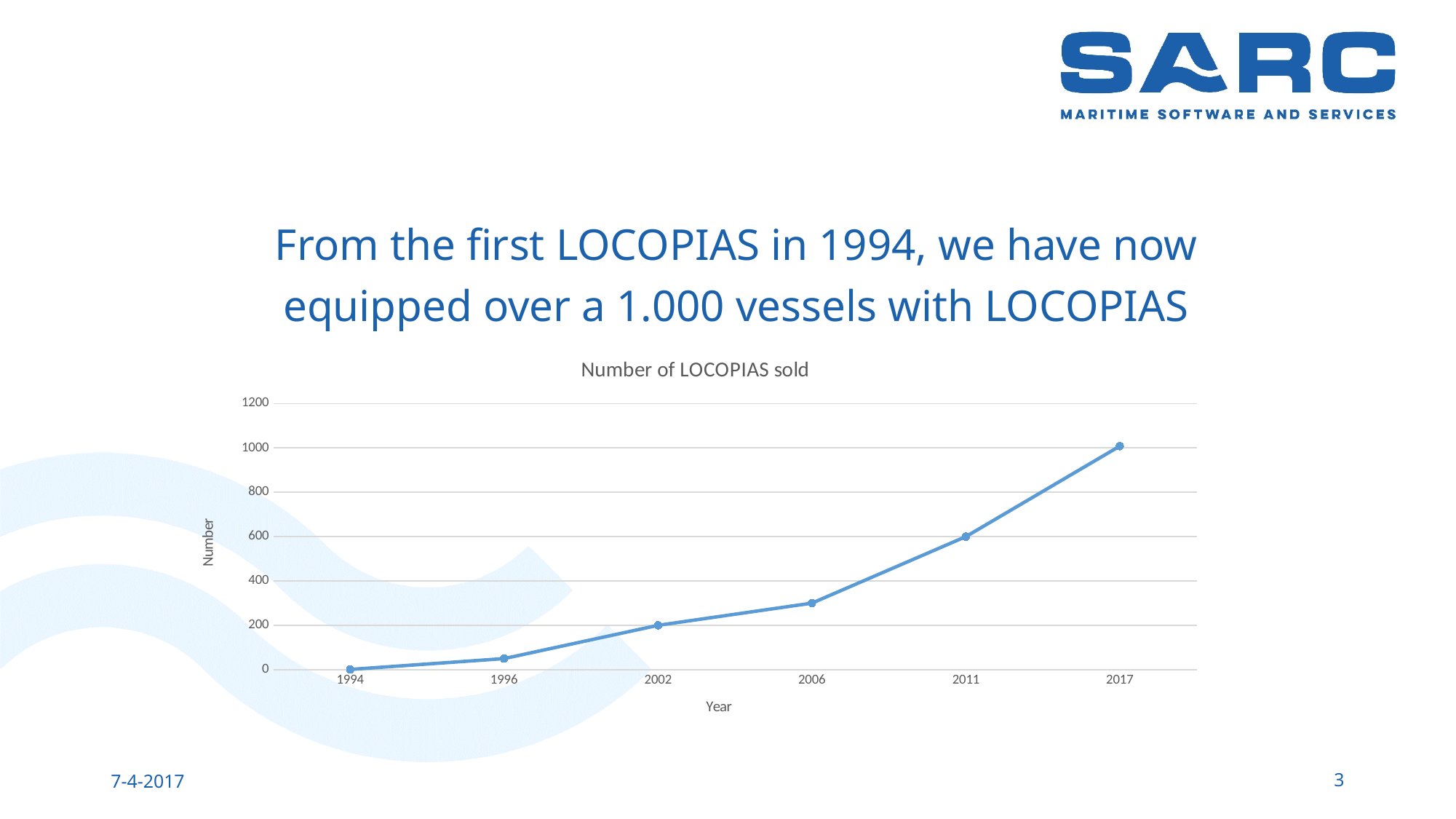
What is the difference between the number sold in 2011 and in 2002? 400 Which is larger, the value for 2006 or the value for 1996? 2006 Which year has the lowest number of LOCOPIAS sold? 1994 How many data points are plotted on the line? 6 What is the title of the chart? Number of LOCOPIAS sold Do the values rise or fall from 1994 to 2017? rise What is the number of LOCOPIAS sold in 2002? 200 What kind of chart is shown on the slide? line chart What is the number of LOCOPIAS sold in 2011? 600 Which year has the highest number of LOCOPIAS sold? 2017 Is the value for 2006 greater or less than 400? less Is the value for 2017 greater or less than 800? greater